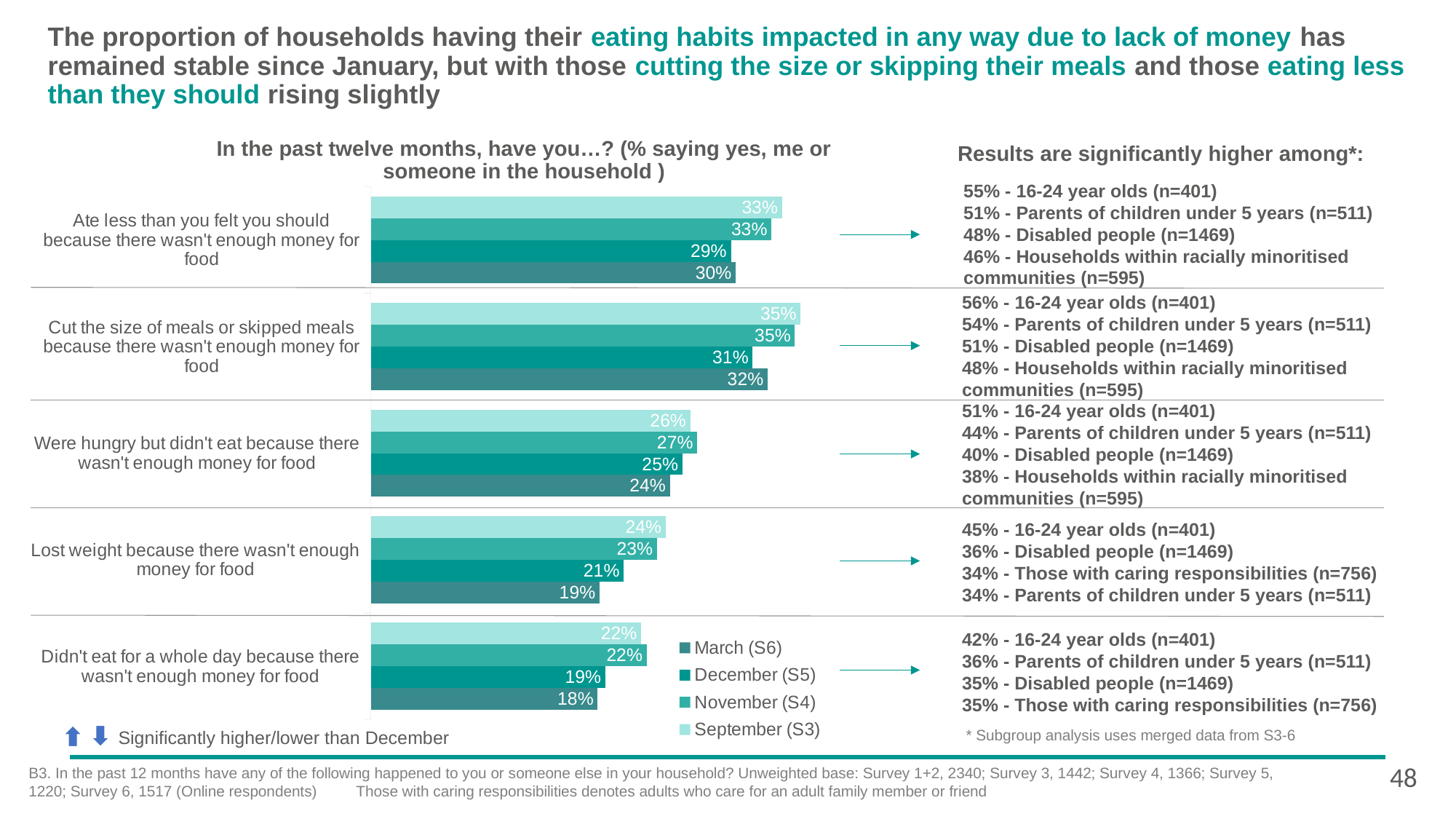
Which survey wave is listed first in the chart legend? March (S6) What is the March (S6) value for 'Cut the size of meals or skipped meals because there wasn't enough money for food'? 32% Which category has the highest March (S6) value? Cut the size of meals or skipped meals because there wasn't enough money for food How many series does the legend list? 4 What is the difference between the September (S3) and March (S6) values for 'Lost weight because there wasn't enough money for food'? 5% How many categories are shown in the bar chart? 5 What is the September (S3) value for 'Lost weight because there wasn't enough money for food'? 24% Which category has the lowest March (S6) value? Didn't eat for a whole day because there wasn't enough money for food For 'Were hungry but didn't eat because there wasn't enough money for food', which is larger: the November (S4) value or the March (S6) value? November (S4) What is the December (S5) value for 'Didn't eat for a whole day because there wasn't enough money for food'? 19% What is the December (S5) value for 'Ate less than you felt you should because there wasn't enough money for food'? 29% What kind of chart is shown on the slide? Bar chart